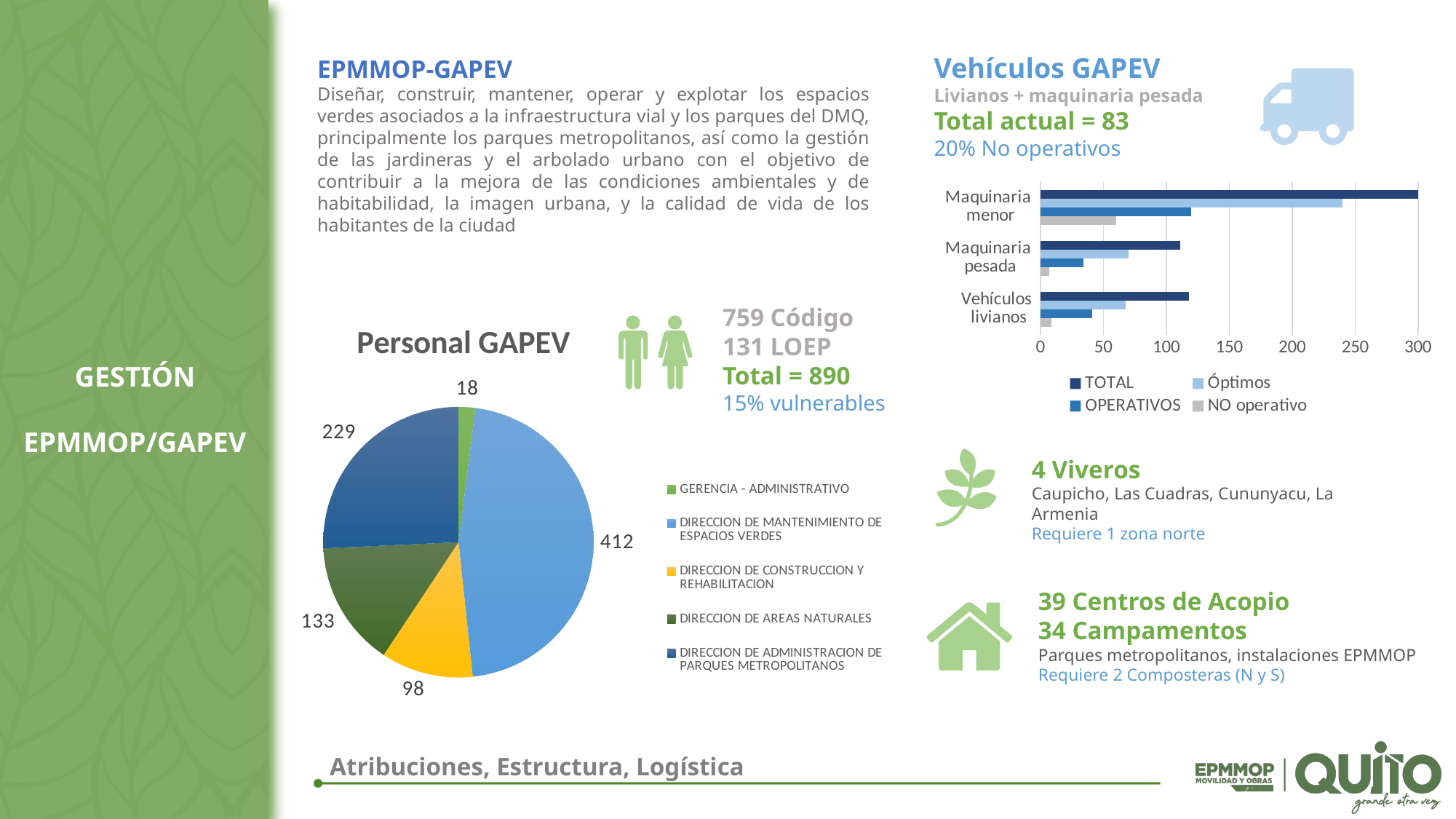
What kind of chart is the Vehículos GAPEV chart? Bar chart In the Vehículos GAPEV chart, is the NO operativo value for Vehículos livianos greater or less than 50? less In the Vehículos GAPEV chart, which category has the highest TOTAL bar? Maquinaria menor In the Personal GAPEV pie chart, which category has the smallest slice? GERENCIA - ADMINISTRATIVO In the Personal GAPEV pie chart, which category has the largest slice? DIRECCION DE MANTENIMIENTO DE ESPACIOS VERDES In the Personal GAPEV pie chart, what is the value for DIRECCION DE MANTENIMIENTO DE ESPACIOS VERDES? 412 In the Vehículos GAPEV chart, is the TOTAL value for Maquinaria menor greater or less than 250? greater How many series does the legend of the Vehículos GAPEV chart list? 4 In the Personal GAPEV pie chart, which is larger: DIRECCION DE CONSTRUCCION Y REHABILITACION or DIRECCION DE AREAS NATURALES? DIRECCION DE AREAS NATURALES In the Personal GAPEV pie chart, what is the difference between DIRECCION DE MANTENIMIENTO DE ESPACIOS VERDES and DIRECCION DE ADMINISTRACION DE PARQUES METROPOLITANOS? 183 In the Personal GAPEV pie chart, what is the value for DIRECCION DE AREAS NATURALES? 133 How many categories does the Personal GAPEV pie chart show? 5